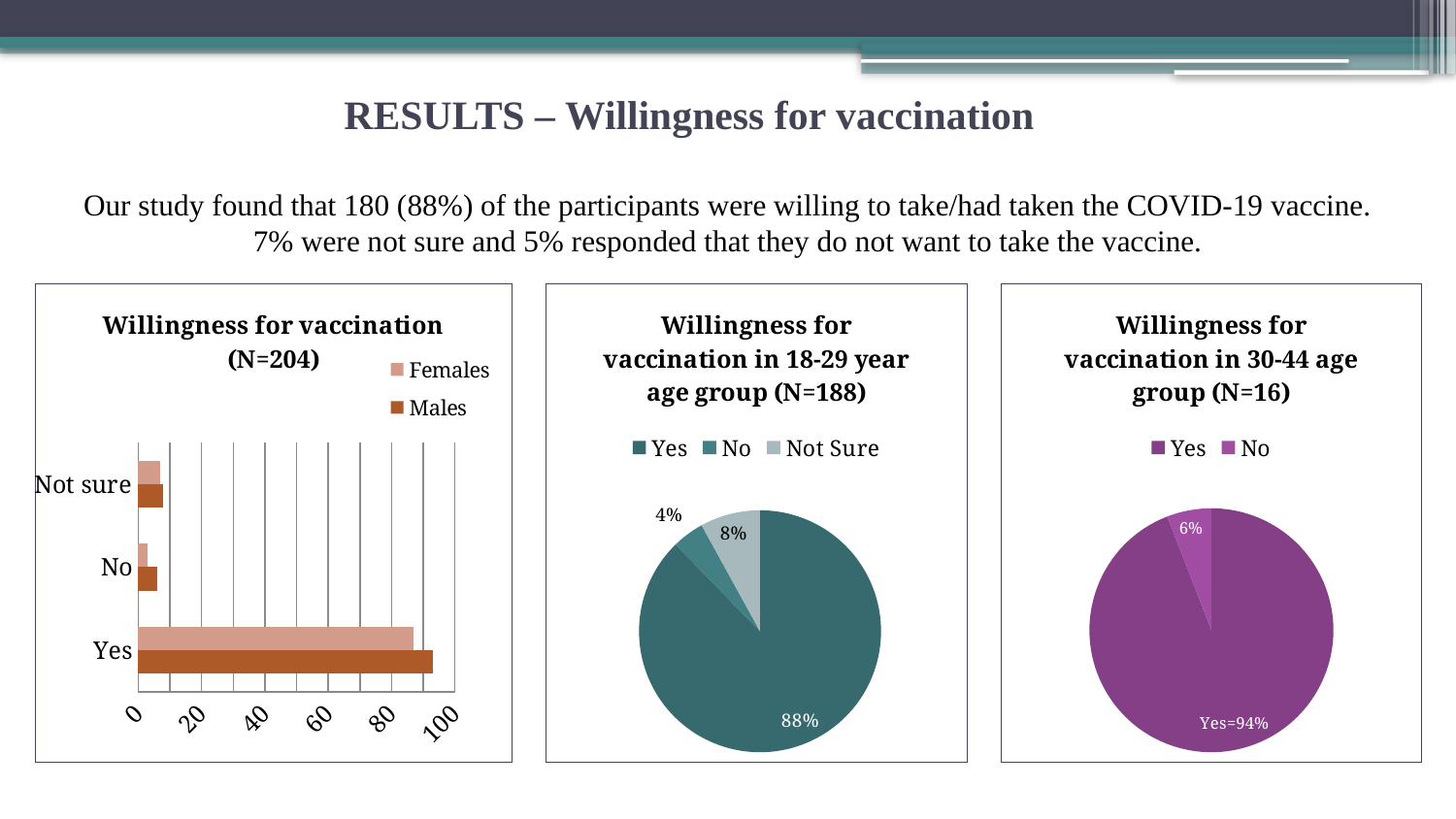
In the 'Willingness for vaccination in 30-44 age group (N=16)' pie chart, what is the difference between the Yes and No shares? 88% How many series does the legend of the 'Willingness for vaccination (N=204)' chart list? 2 In the 'Willingness for vaccination in 18-29 year age group (N=188)' pie chart, which slice is the smallest? No In the 'Willingness for vaccination in 18-29 year age group (N=188)' pie chart, what share is Not Sure? 8% In the 'Willingness for vaccination (N=204)' chart, which is larger for Yes: Males or Females? Males In the 'Willingness for vaccination in 18-29 year age group (N=188)' pie chart, what share is Yes? 88% In the 'Willingness for vaccination (N=204)' chart, is the Males value for No greater or less than 20? less What kind of chart is the 'Willingness for vaccination (N=204)' chart on the left? bar chart In the 'Willingness for vaccination (N=204)' chart, is the Females value for Yes greater or less than 80? greater In the 'Willingness for vaccination (N=204)' chart, which category has the highest values? Yes In the 'Willingness for vaccination in 30-44 age group (N=16)' pie chart, what share is No? 6% How many categories are shown in the 'Willingness for vaccination (N=204)' chart? 3